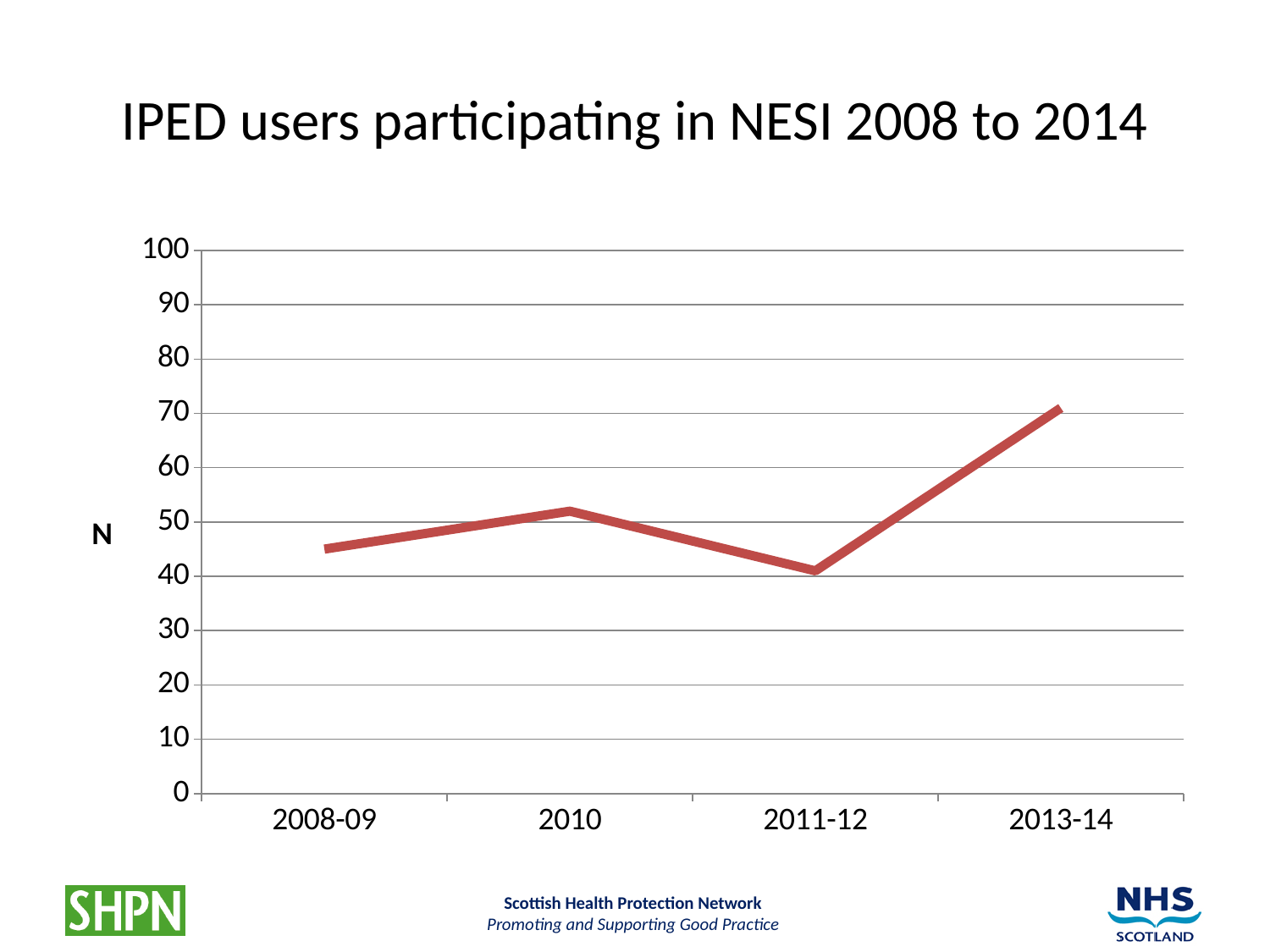
Which is larger, the value for 2010 or the value for 2008-09? 2010 Is the value for 2010 greater or less than 60? less What is the label on the vertical axis? N Which period has the lowest number of IPED users participating in NESI? 2011-12 What kind of chart is shown on the slide? line chart How many time periods are plotted along the x axis? 4 What is the title of the chart? IPED users participating in NESI 2008 to 2014 Is the value for 2008-09 greater or less than 40? greater Is the value for 2011-12 greater or less than 50? less Which period has the highest number of IPED users participating in NESI? 2013-14 Does the number of IPED users rise or fall between 2011-12 and 2013-14? rise